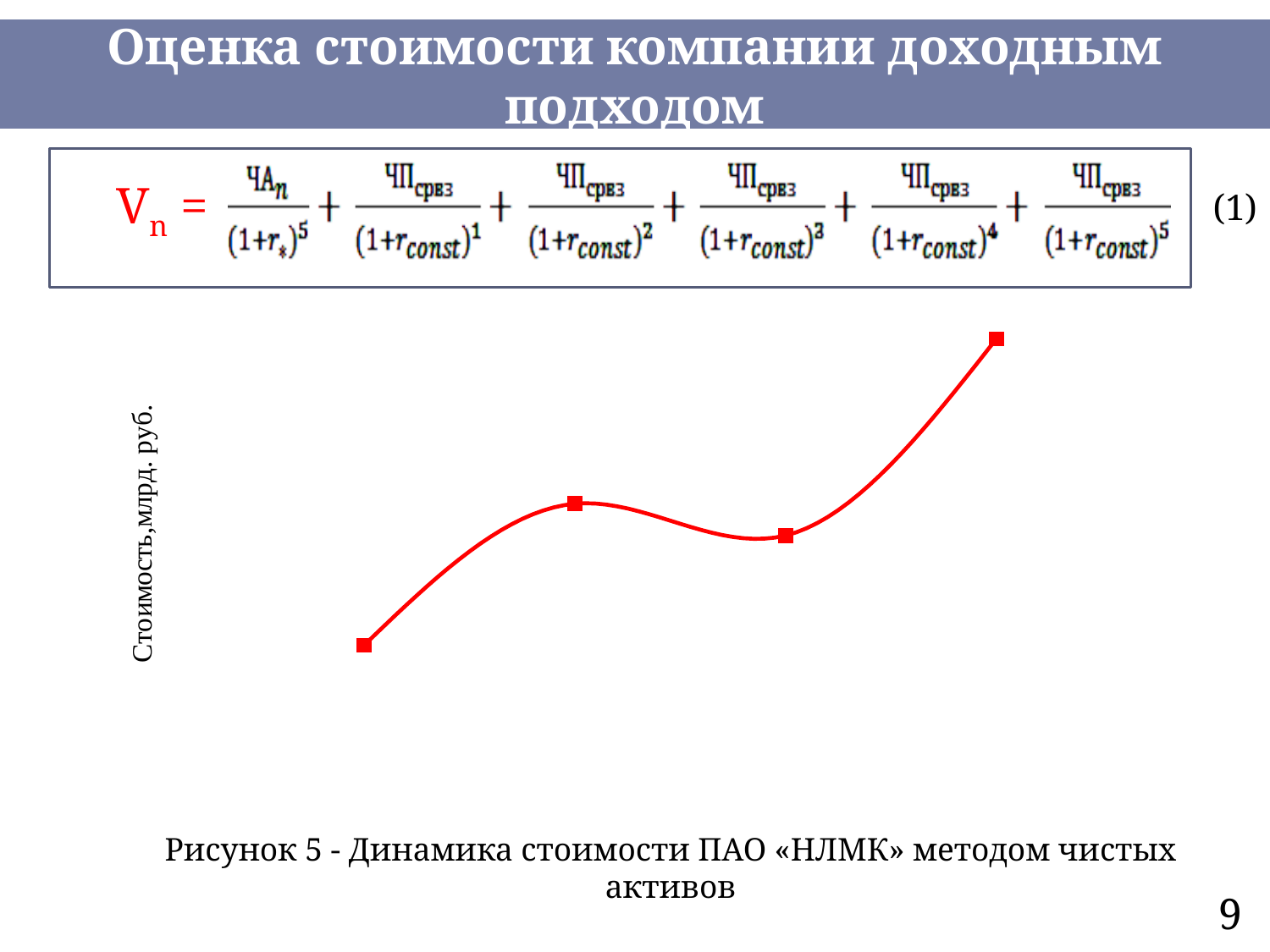
Which plotted point on the line chart has the lowest value: the first, second, third or fourth? first On the line chart, is the third point or the fourth point higher? fourth point What is the label on the vertical axis of the chart? Стоимость,млрд. руб. Overall, do the values on the line chart rise or fall from the first point to the last point? rise Does the line chart fall between the second and third points? yes On the line chart, is the second point or the third point higher? second point What kind of chart is shown on the slide? line chart How many data points are plotted on the line chart? 4 What is the caption (figure title) given below the chart? Рисунок 5 - Динамика стоимости ПАО «НЛМК» методом чистых активов Which plotted point on the line chart has the highest value: the first, second, third or fourth? fourth